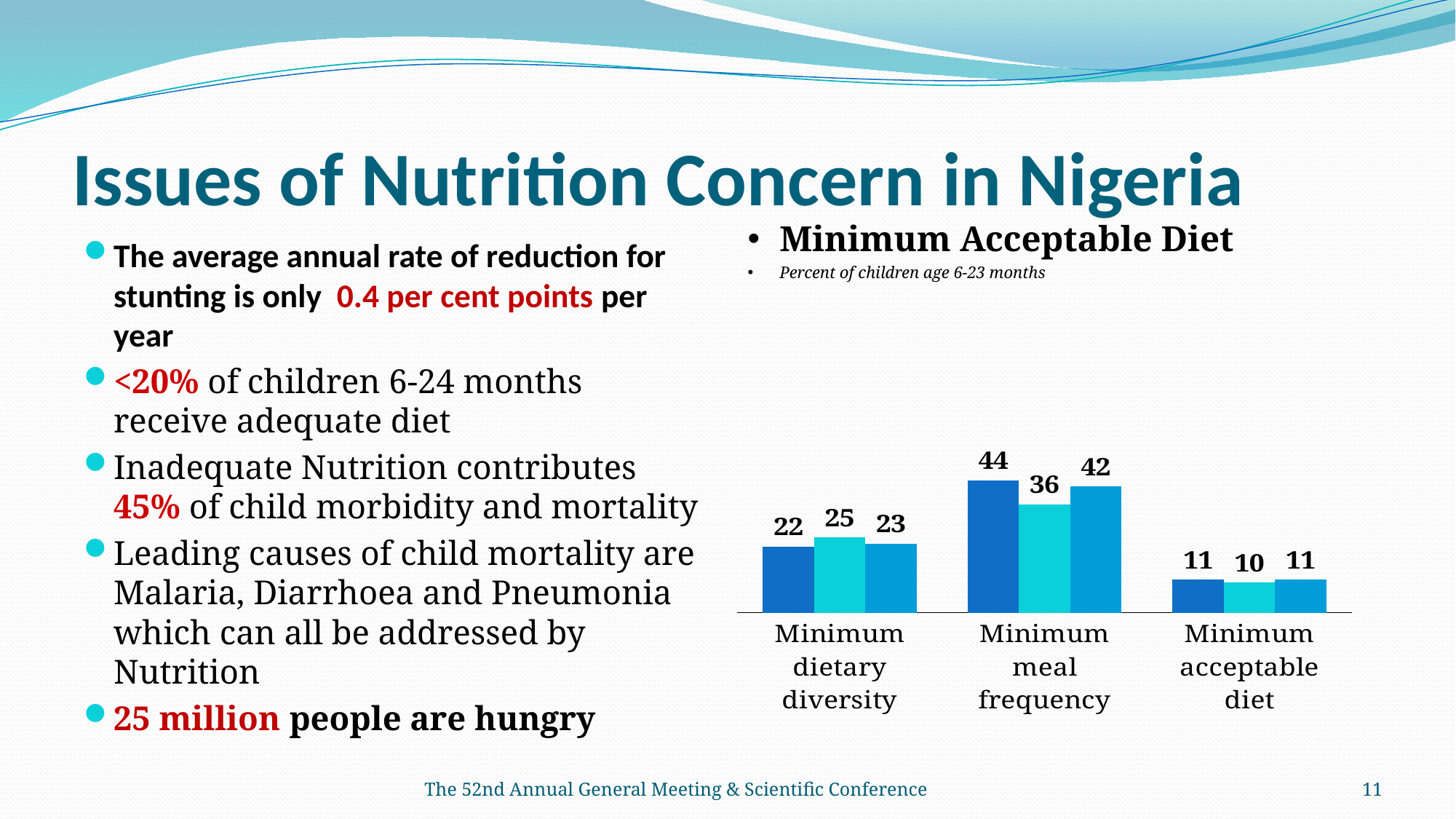
How many categories are shown on the x axis of the chart? 3 What is the value of the first (dark blue) bar for Minimum meal frequency? 44 Which category has the highest values in the chart? Minimum meal frequency How many bars are plotted for each category in the chart? 3 What is the value of the middle (light cyan) bar for Minimum dietary diversity? 25 Which category has the lowest values in the chart? Minimum acceptable diet What type of chart is shown on the slide? bar chart What is the difference between the first bar for Minimum meal frequency (44) and the first bar for Minimum dietary diversity (22)? 22 What is the value of the middle (light cyan) bar for Minimum acceptable diet? 10 Within Minimum meal frequency, which is larger: the first bar or the middle bar? the first bar (44) What is the value of the third bar for Minimum meal frequency? 42